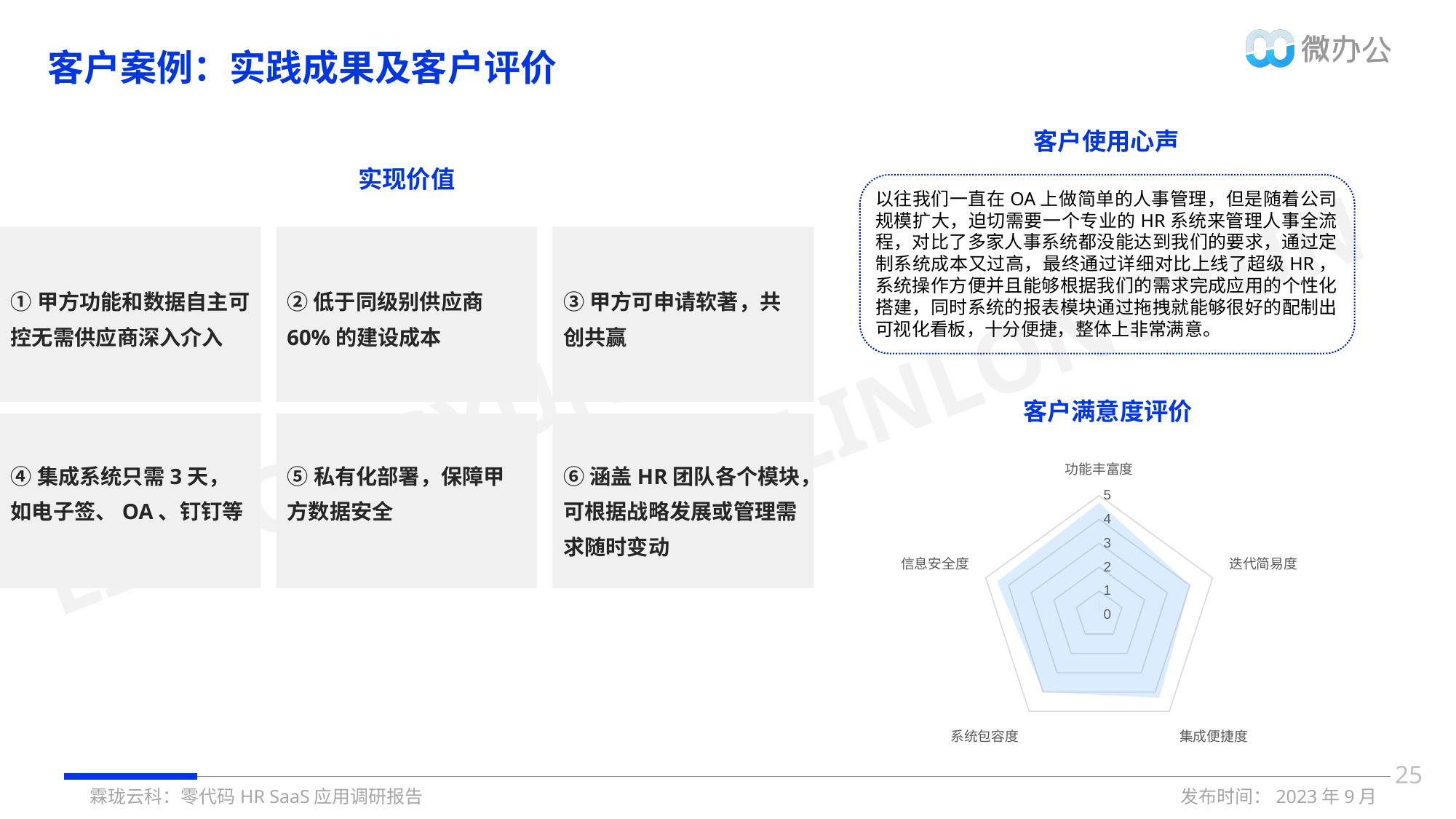
What kind of chart is shown under 客户满意度评价? radar chart Which category label appears at the top of the 客户满意度评价 radar chart? 功能丰富度 In the 客户满意度评价 chart, is the value for 迭代简易度 greater or less than 3? greater In the 客户满意度评价 chart, is the value for 系统包容度 greater or less than 2? greater In the 客户满意度评价 chart, is the value for 功能丰富度 greater or less than 3? greater What is the maximum value shown on the axis scale of the 客户满意度评价 chart? 5 What is the title of the chart on the slide? 客户满意度评价 How many categories (axes) does the 客户满意度评价 radar chart have? 5